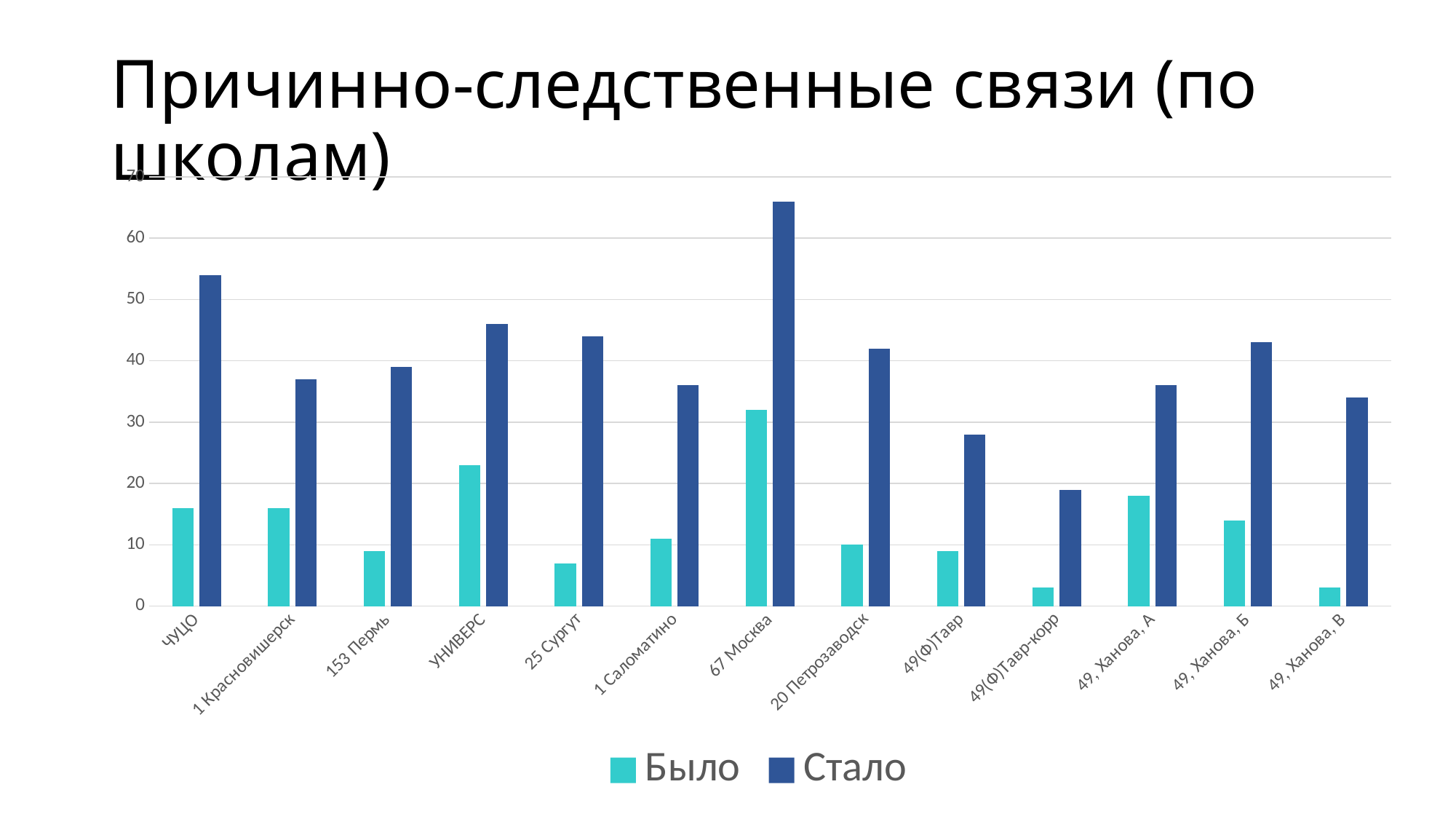
Is the Стало value for ЧУЦО greater or less than 50? greater Is the Было value for УНИВЕРС greater or less than 20? greater Which school has the highest value for Было? 67 Москва Which school has the lowest value for Стало? 49(Ф)Тавр-корр Which is larger: the Стало value for ЧУЦО or the Стало value for УНИВЕРС? ЧУЦО What are the two series named in the legend? Было and Стало Is the Было value for 25 Сургут greater or less than 10? less Which school has the highest value for Стало? 67 Москва How many schools (categories) are shown on the x axis? 13 How many series does the legend list? 2 What kind of chart is shown on the slide? bar chart